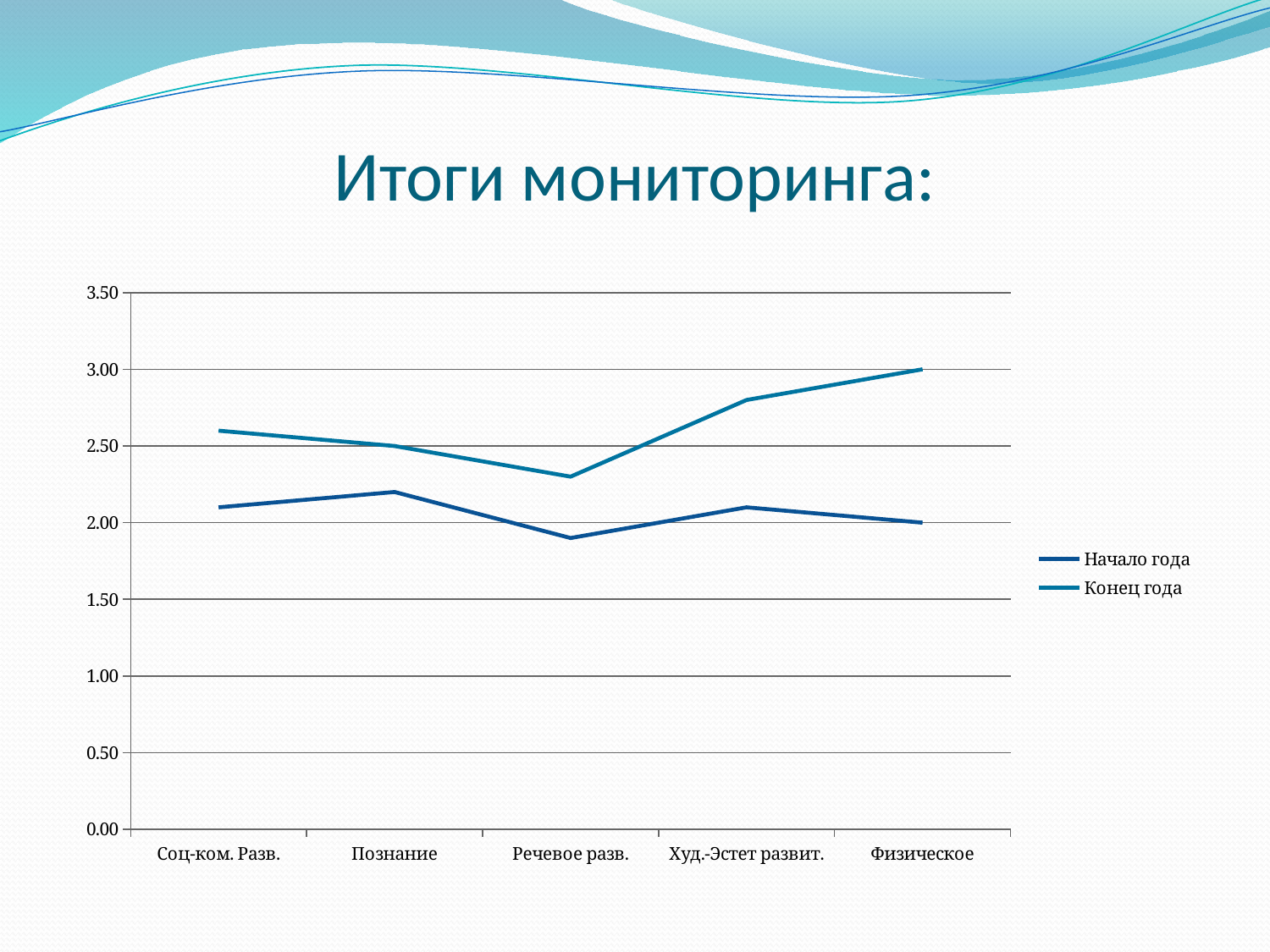
Is the value for Худ.-Эстет развит. in the Конец года series greater or less than 2.50? greater Which series has the larger value for Соц-ком. Разв., Начало года or Конец года? Конец года How many series does the legend list? 2 Which category has the highest value in the Конец года series? Физическое What is the value for Физическое in the Начало года series? 2.00 What is the value for Физическое in the Конец года series? 3.00 What kind of chart is shown on the slide? line chart Which category has the lowest value in the Конец года series? Речевое разв. How many categories are shown on the x axis? 5 Is the value for Речевое разв. in the Начало года series greater or less than 2.00? less What is the title of the slide? Итоги мониторинга: Does the Конец года line rise or fall from Речевое разв. to Физическое? rise